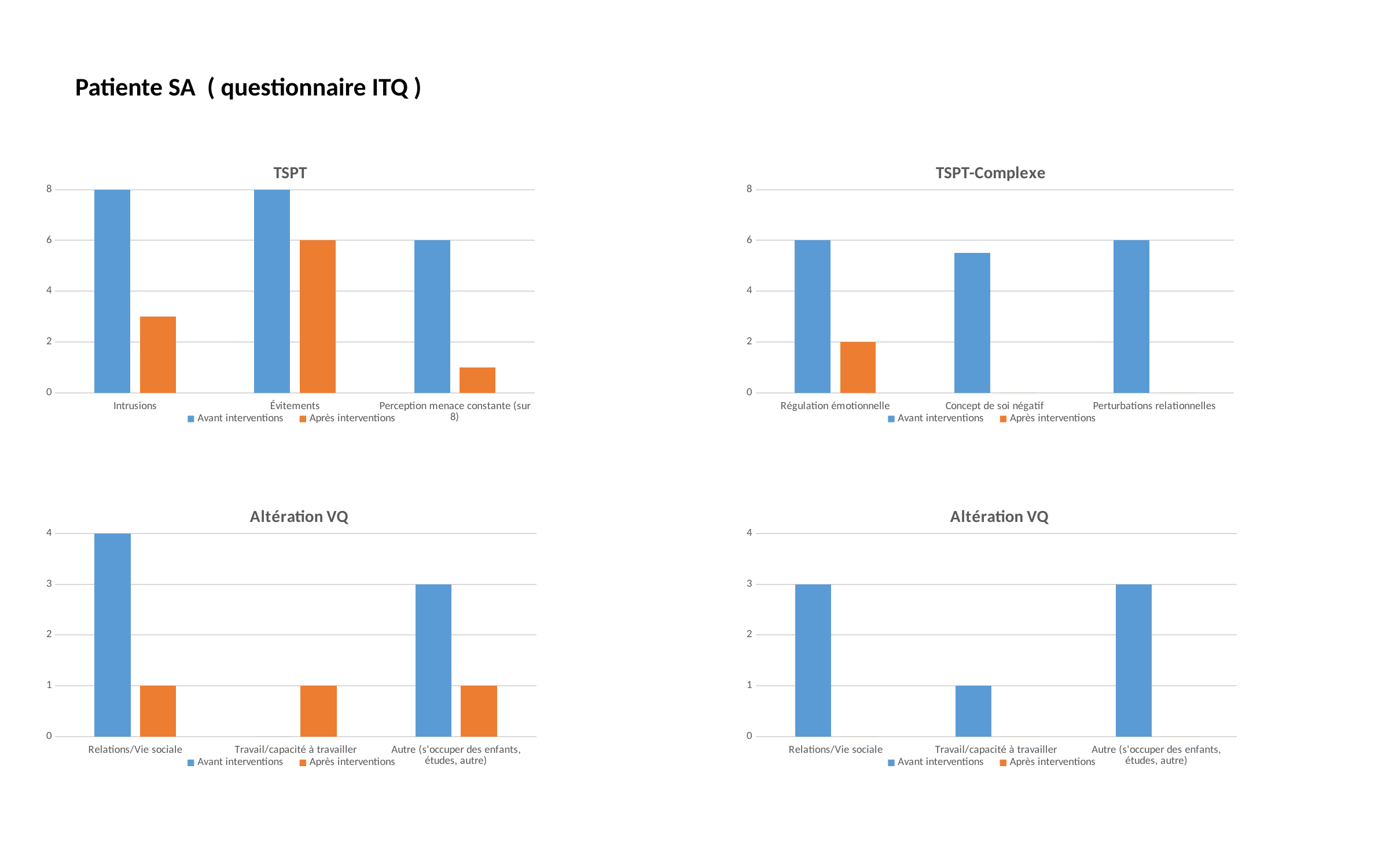
In the TSPT-Complexe chart, which category has the lowest Avant interventions value? Concept de soi négatif What type of chart is the TSPT-Complexe chart? bar chart In the TSPT chart, what is the value of Avant interventions for Intrusions? 8 In the TSPT-Complexe chart, is the value of Avant interventions for Concept de soi négatif greater or less than 4? greater In the bottom-right Altération VQ chart, how many series does the legend list? 2 In the TSPT chart, how many categories are shown on the x axis? 3 In the TSPT-Complexe chart, what is the value of Après interventions for Régulation émotionnelle? 2 In the bottom-right Altération VQ chart, what is the value of Avant interventions for Travail/capacité à travailler? 1 In the TSPT chart, is the value of Après interventions for Intrusions greater or less than 4? less In the bottom-left Altération VQ chart, what is the difference between Avant interventions and Après interventions for Relations/Vie sociale? 3 In the TSPT chart, what is the value of Après interventions for Évitements? 6 In the bottom-left Altération VQ chart, what is the value of Avant interventions for Relations/Vie sociale? 4